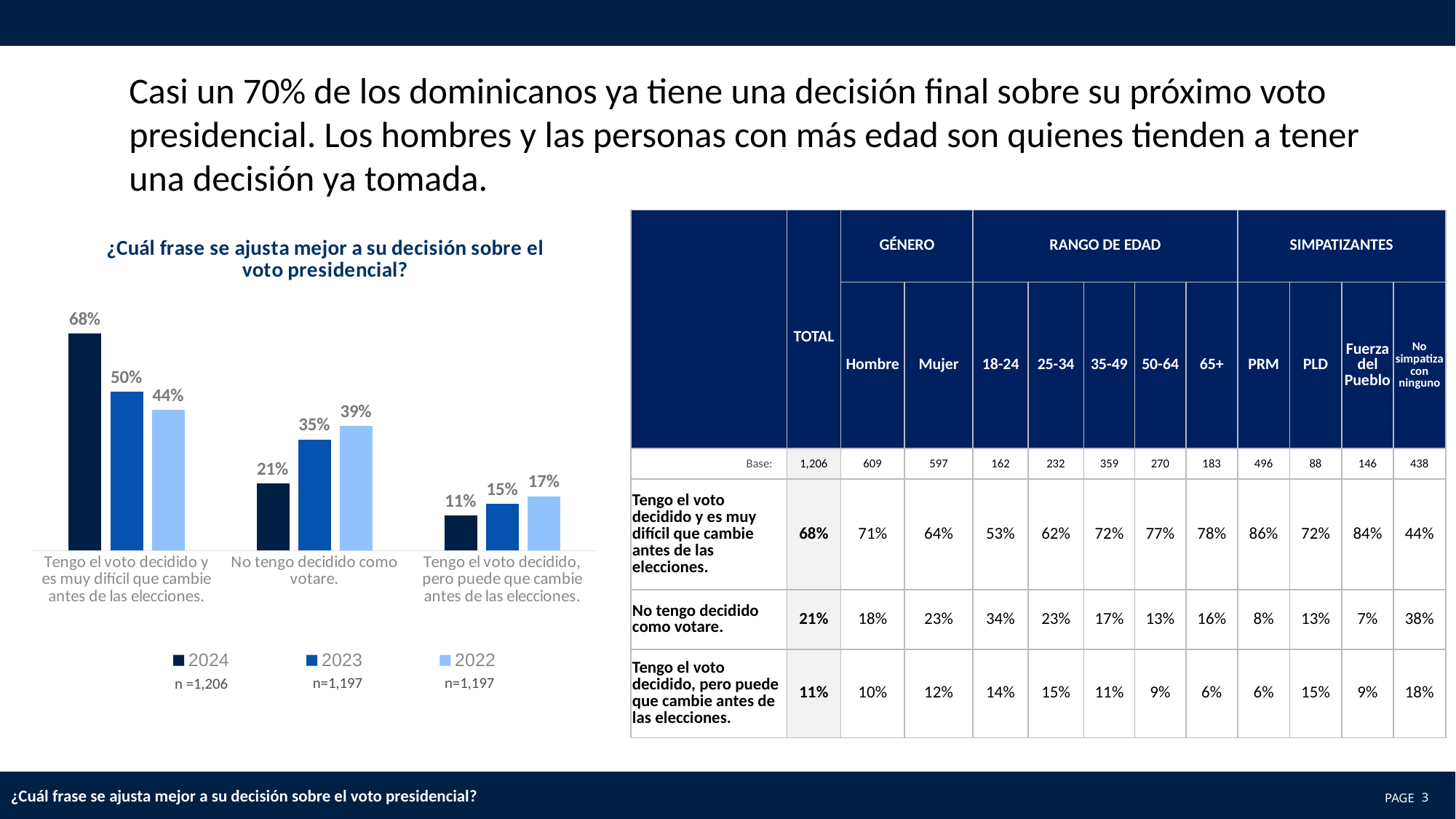
What kind of chart is shown on the slide? Bar chart What is the 2023 value for 'Tengo el voto decidido, pero puede que cambie antes de las elecciones'? 15% How many series does the chart legend list? 3 How many categories are shown on the x axis of the chart? 3 What is the 2024 value for 'Tengo el voto decidido y es muy difícil que cambie antes de las elecciones'? 68% For 'No tengo decidido como votare.', which is larger: the 2023 value or the 2022 value? 2022 What is the 2022 value for 'No tengo decidido como votare.'? 39% What is the title of the chart? ¿Cuál frase se ajusta mejor a su decisión sobre el voto presidencial? Which category has the highest 2024 value? Tengo el voto decidido y es muy difícil que cambie antes de las elecciones. What sample size (n) is shown for the 2024 series in the legend? n =1,206 Which category has the lowest 2022 value? Tengo el voto decidido, pero puede que cambie antes de las elecciones. What is the difference between the 2024 and 2022 values for 'Tengo el voto decidido y es muy difícil que cambie antes de las elecciones'? 24 percentage points